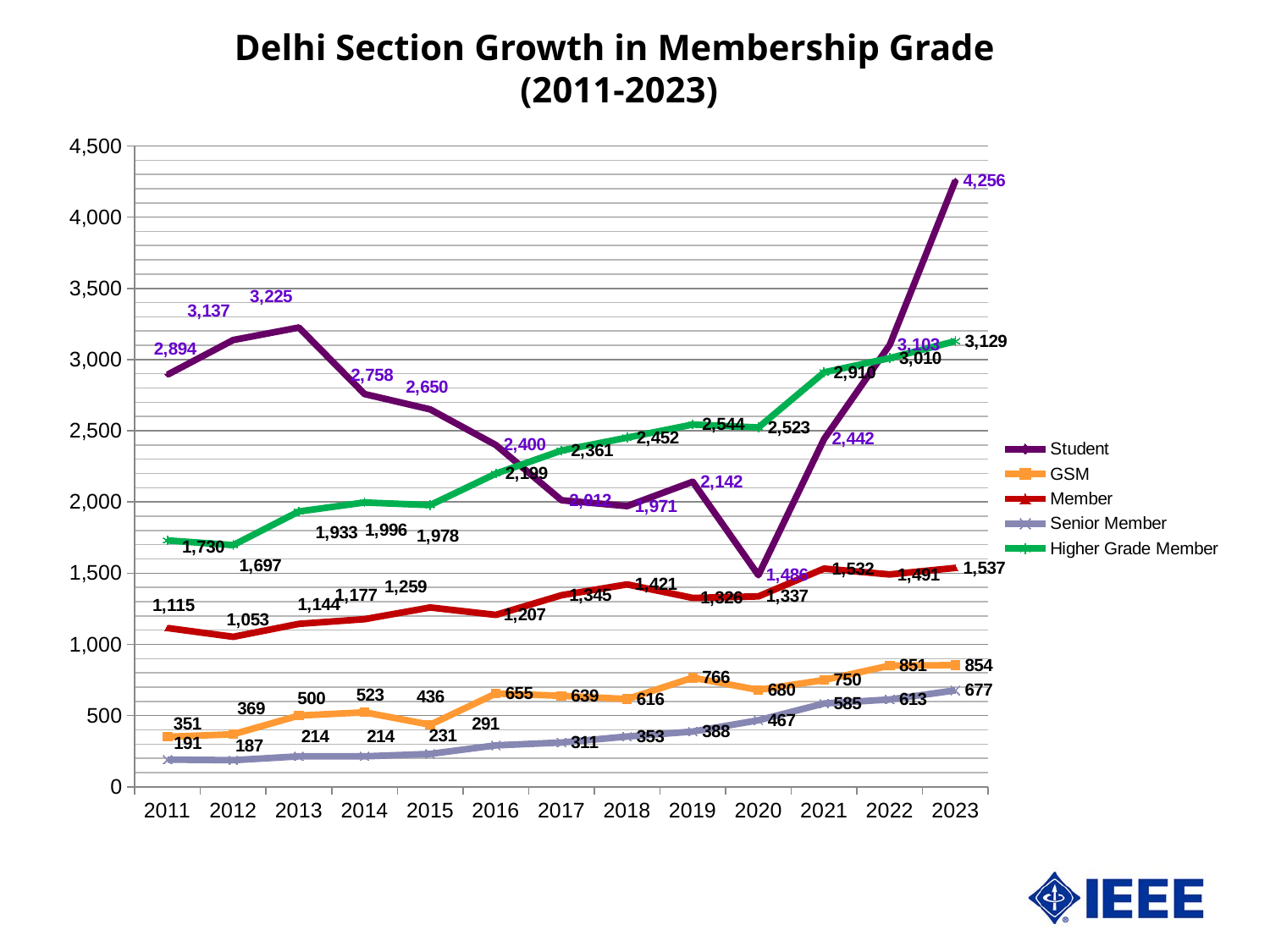
What is the value for Senior Member in 2011? 191 What is the difference between the Higher Grade Member values in 2023 and 2011? 1,399 What is the value for Member in 2012? 1,053 What is the value for Student in 2023? 4,256 How many series does the legend list? 5 What is the value for GSM in 2022? 851 In 2023, which is larger: Member or Higher Grade Member? Higher Grade Member In which year does the Student series reach its highest value? 2023 Is the value for Student in 2020 greater or less than 2,000? less In which year is the GSM value lowest? 2011 Does the Senior Member series generally rise or fall from 2011 to 2023? rise What kind of chart is shown on the slide? line chart